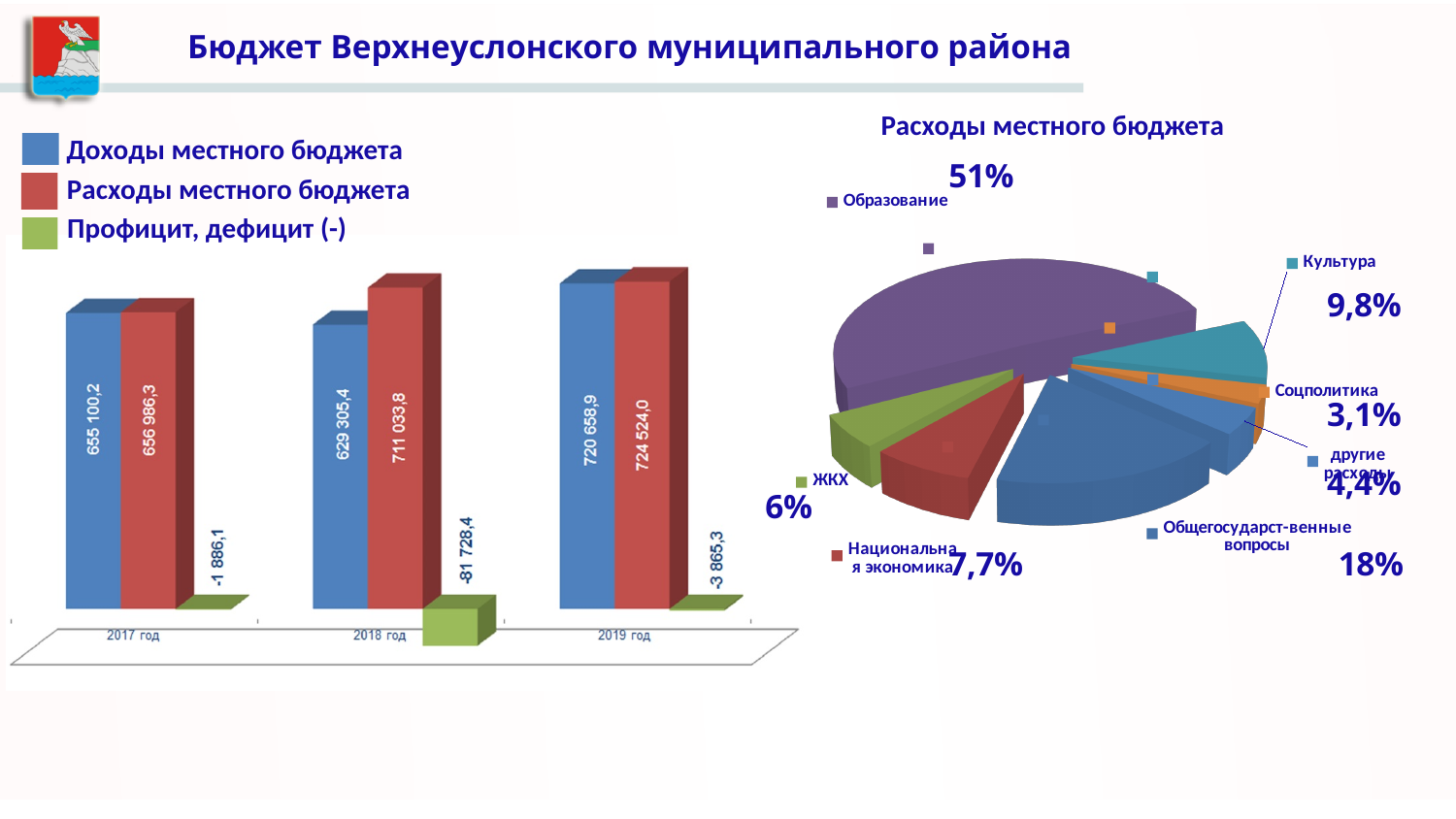
On the left bar chart, what is the value of Доходы местного бюджета for 2019 год? 720 658,9 On the left bar chart, which year has the highest value of Расходы местного бюджета? 2019 год On the pie chart Расходы местного бюджета, what share does Образование have? 51% On the left bar chart, how many series does the legend list? 3 On the left bar chart, how many years are shown on the x axis? 3 On the pie chart Расходы местного бюджета, which is larger: Культура or Национальная экономика? Культура On the left bar chart, what is the value of Профицит, дефицит (-) for 2017 год? -1 886,1 On the pie chart Расходы местного бюджета, which category has the smallest share? Соцполитика On the pie chart Расходы местного бюджета, what share does Общегосударственные вопросы have? 18% What kind of chart is the chart on the left of the slide? Bar chart On the left bar chart, which year has the lowest value of Доходы местного бюджета? 2018 год On the left bar chart, what is the value of Расходы местного бюджета for 2018 год? 711 033,8